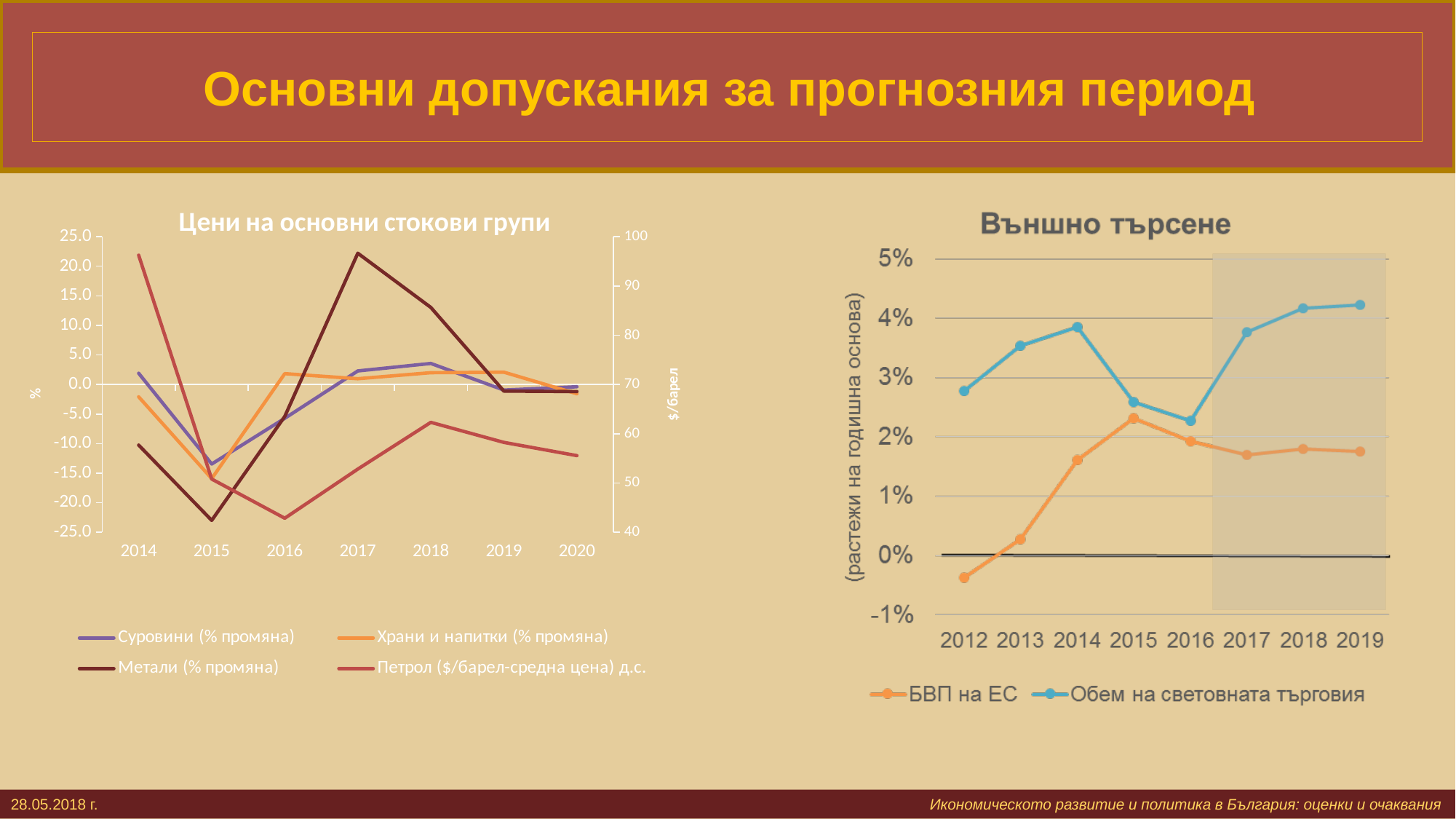
In "Цени на основни стокови групи", is the value of Петрол ($/барел-средна цена) in 2014 greater or less than 90 on the right axis? greater In "Цени на основни стокови групи", in which year does the Метали (% промяна) series reach its highest value? 2017 In "Външно търсене", in which year is Обем на световната търговия at its highest? 2019 How many years are shown on the x axis of "Цени на основни стокови групи"? 7 In "Цени на основни стокови групи", in which year is the Петрол ($/барел-средна цена) series at its lowest? 2016 In "Цени на основни стокови групи", which series has the lowest value in 2015: Метали (% промяна) or Суровини (% промяна)? Метали (% промяна) What type of chart is "Цени на основни стокови групи"? line chart In "Външно търсене", is the value of БВП на ЕС in 2012 greater or less than 0%? less In "Цени на основни стокови групи", is the value of Метали (% промяна) in 2017 greater or less than 20.0? greater In "Външно търсене", which series has the larger value in 2014: БВП на ЕС or Обем на световната търговия? Обем на световната търговия How many series does the legend of "Външно търсене" list? 2 How many series does the legend of "Цени на основни стокови групи" list? 4